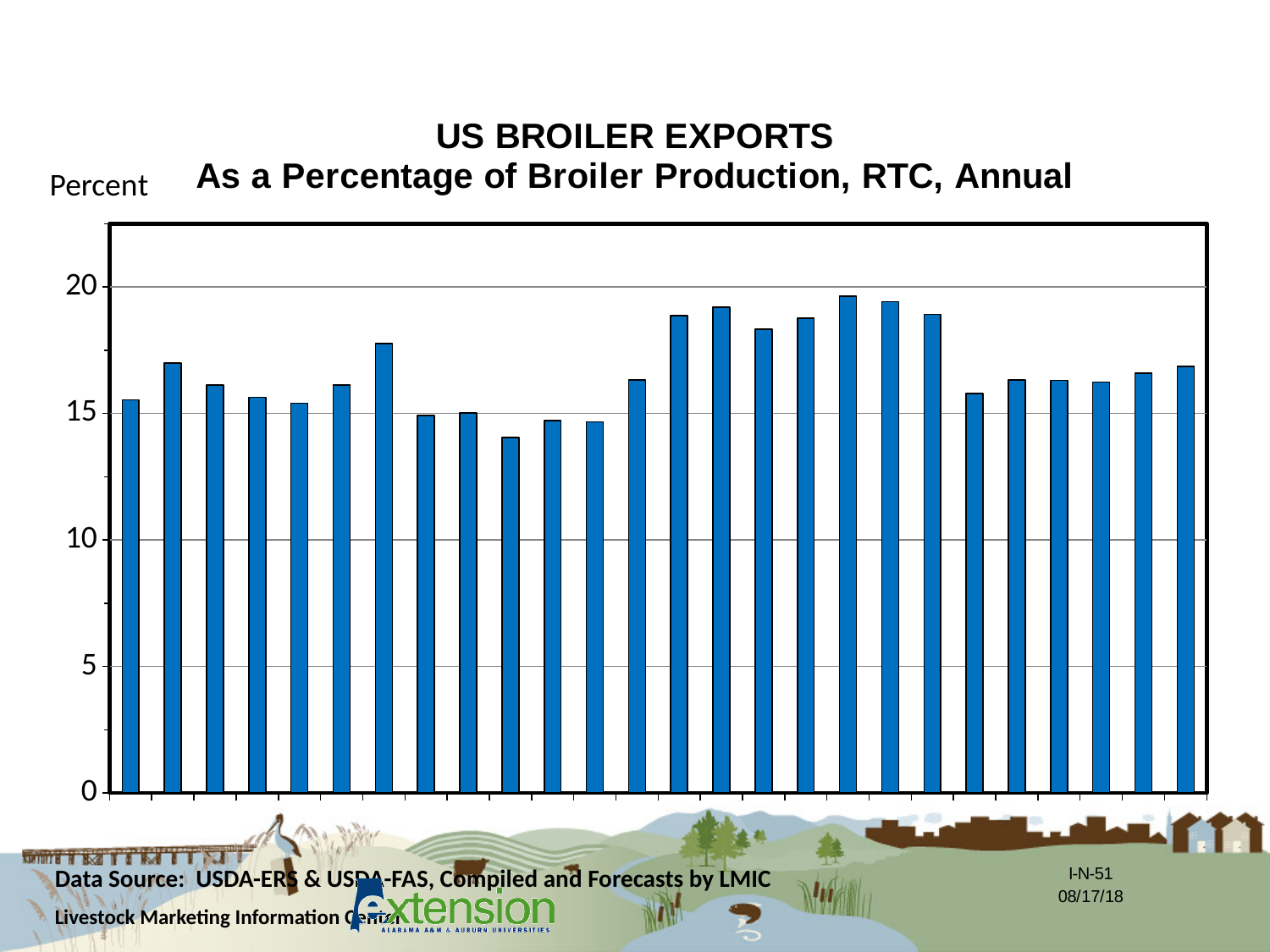
Which is larger, the first bar or the second bar from the left? The second bar Is the value of the shortest bar greater or less than 15? less Is the value of the first (leftmost) bar greater or less than 20? less What kind of chart is shown on the slide? Bar chart What is the title of the chart? US BROILER EXPORTS As a Percentage of Broiler Production, RTC, Annual Is the value of the tallest bar greater or less than 20? less Is the shortest bar located in the left half or the right half of the chart? Left half How many bars are plotted in the chart? 26 Is the tallest bar located in the left half or the right half of the chart? Right half What label is shown on the vertical axis of the chart? Percent From the shortest bar to the tallest bar, do the values generally rise or fall? Rise